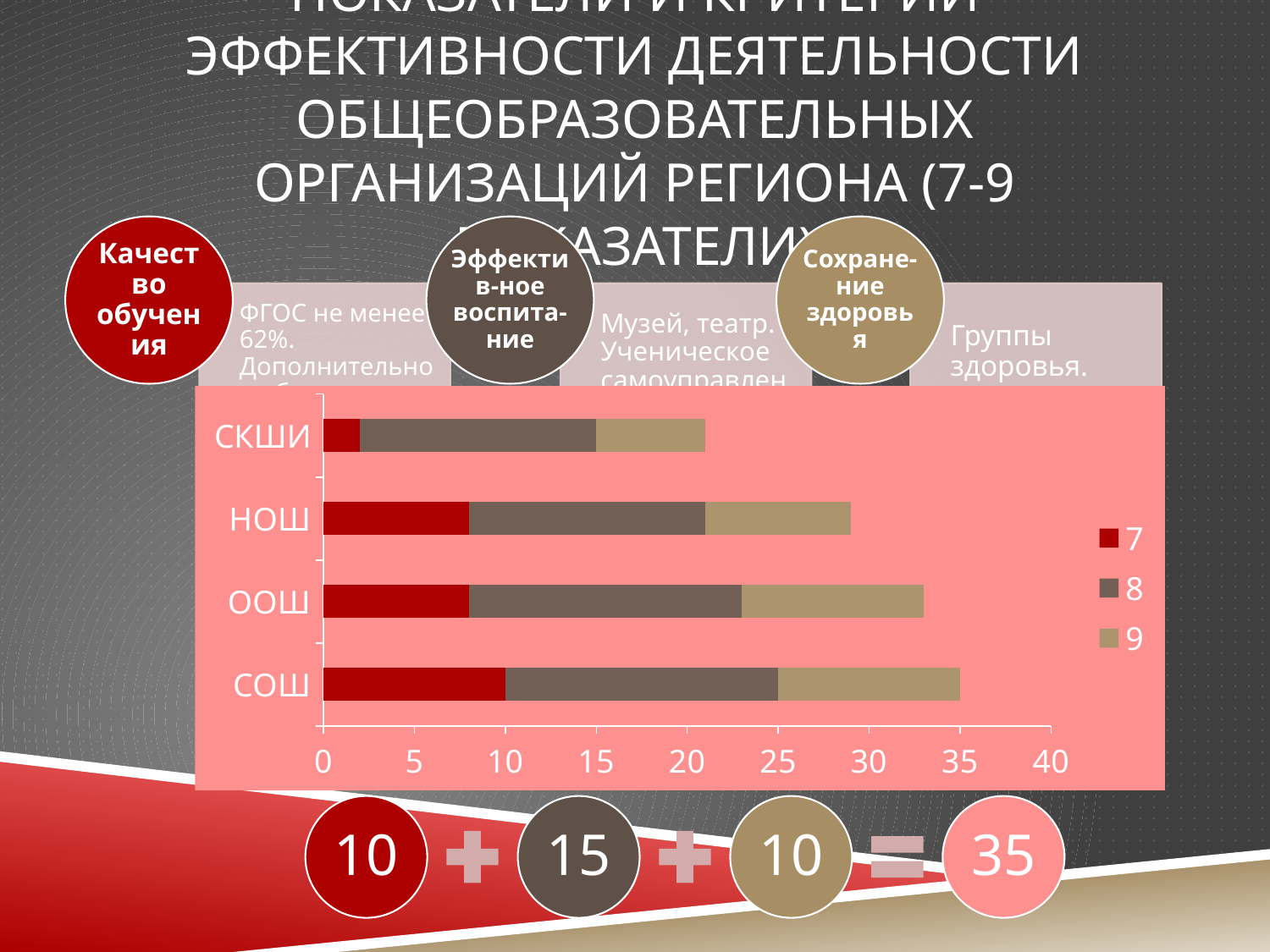
Which category has the shortest total stacked bar? СКШИ How many series does the chart legend list? 3 Is the value of series 7 for СКШИ greater or less than 5? less What kind of chart is shown on the slide? bar chart Which category has the longest total stacked bar? СОШ Is the total stacked bar for ООШ greater or less than 30? greater How many categories are plotted on the vertical axis of the chart? 4 What are the entries listed in the chart legend? 7, 8, 9 What is the value of series 7 for СОШ? 10 Which has the longer total stacked bar, ООШ or НОШ? ООШ What is the total of the stacked bar for СОШ? 35 Is the total stacked bar for СКШИ greater or less than 25? less